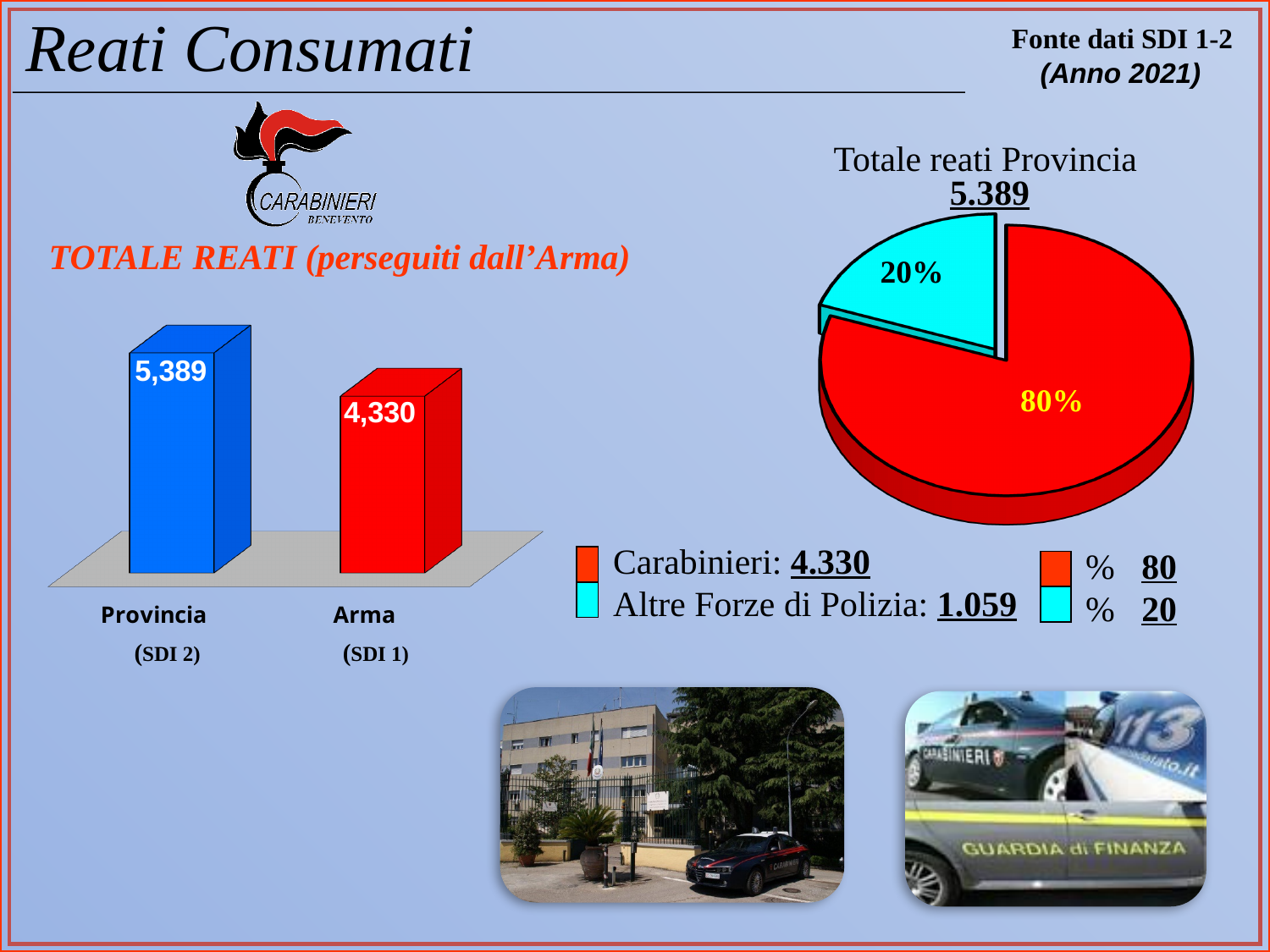
What kind of chart is shown on the left of the slide? Bar chart In the pie chart 'Totale reati Provincia', what share is shown for Carabinieri? 80% In the bar chart on the left, which category has the higher value? Provincia In the bar chart on the left, what is the difference between the Provincia and Arma values? 1,059 In the pie chart 'Totale reati Provincia', which slice is the smallest? Altre Forze di Polizia In the bar chart on the left, what is the value for Provincia (SDI 2)? 5,389 In the bar chart on the left, how many bars are shown? 2 In the pie chart 'Totale reati Provincia', what value is given for Altre Forze di Polizia in the legend? 1.059 In the pie chart 'Totale reati Provincia', what share is shown for Altre Forze di Polizia? 20% In the bar chart on the left, what is the value for Arma (SDI 1)? 4,330 What total is printed under the title of the pie chart 'Totale reati Provincia'? 5.389 In the pie chart 'Totale reati Provincia', what colour is the Carabinieri slice? Red